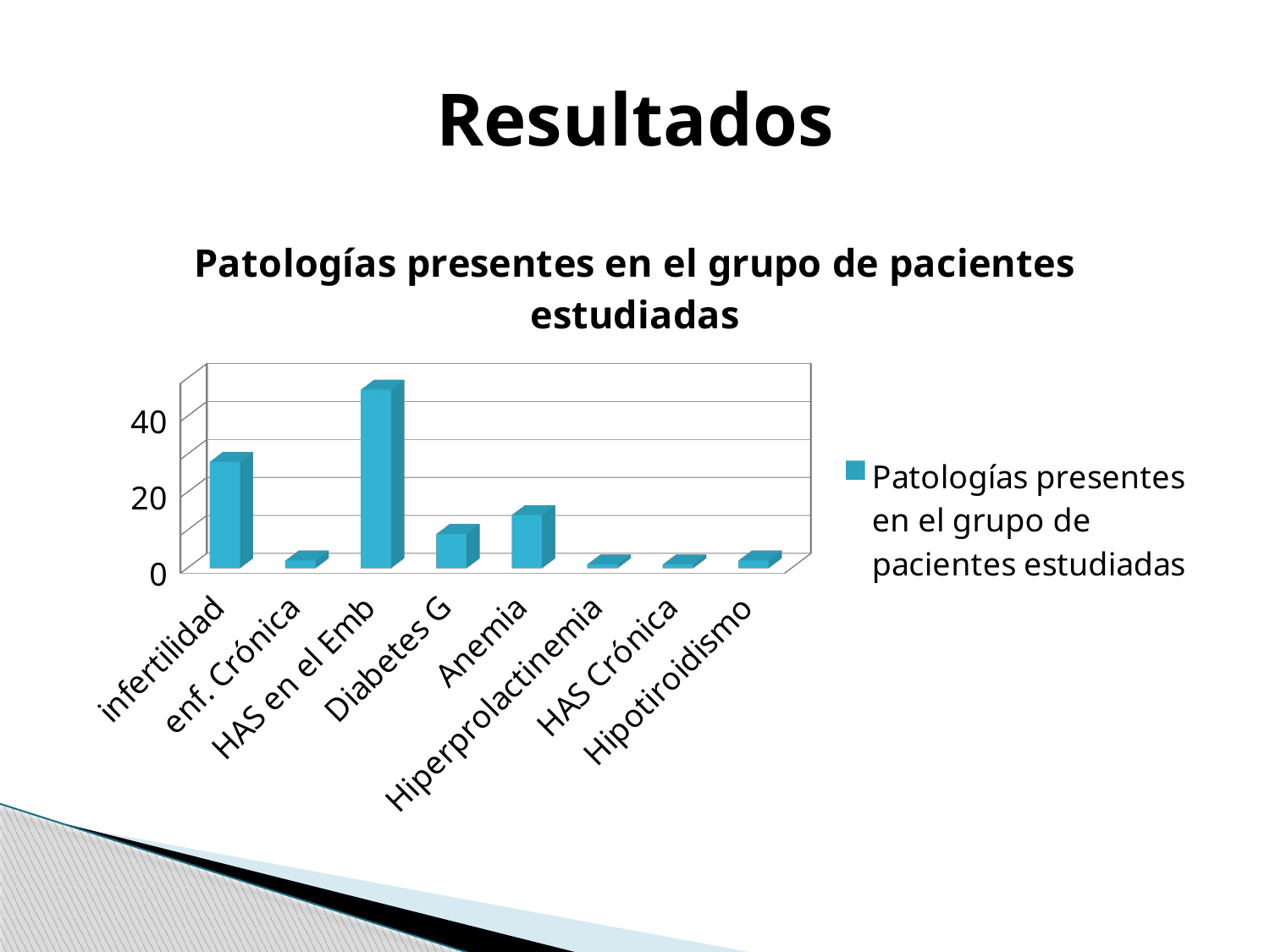
What kind of chart is shown on the slide? bar chart How many series does the chart legend list? 1 Which category has the highest value in the chart? HAS en el Emb Which is larger, the value for infertilidad or the value for Anemia? infertilidad How many categories are shown on the x axis of the chart? 8 Is the value for Diabetes G greater or less than 20? less Which is larger, the value for HAS en el Emb or the value for infertilidad? HAS en el Emb Is the value for HAS en el Emb greater or less than 40? greater What is the title of the chart? Patologías presentes en el grupo de pacientes estudiadas What colour are the bars in the chart? blue Is the value for infertilidad greater or less than 20? greater